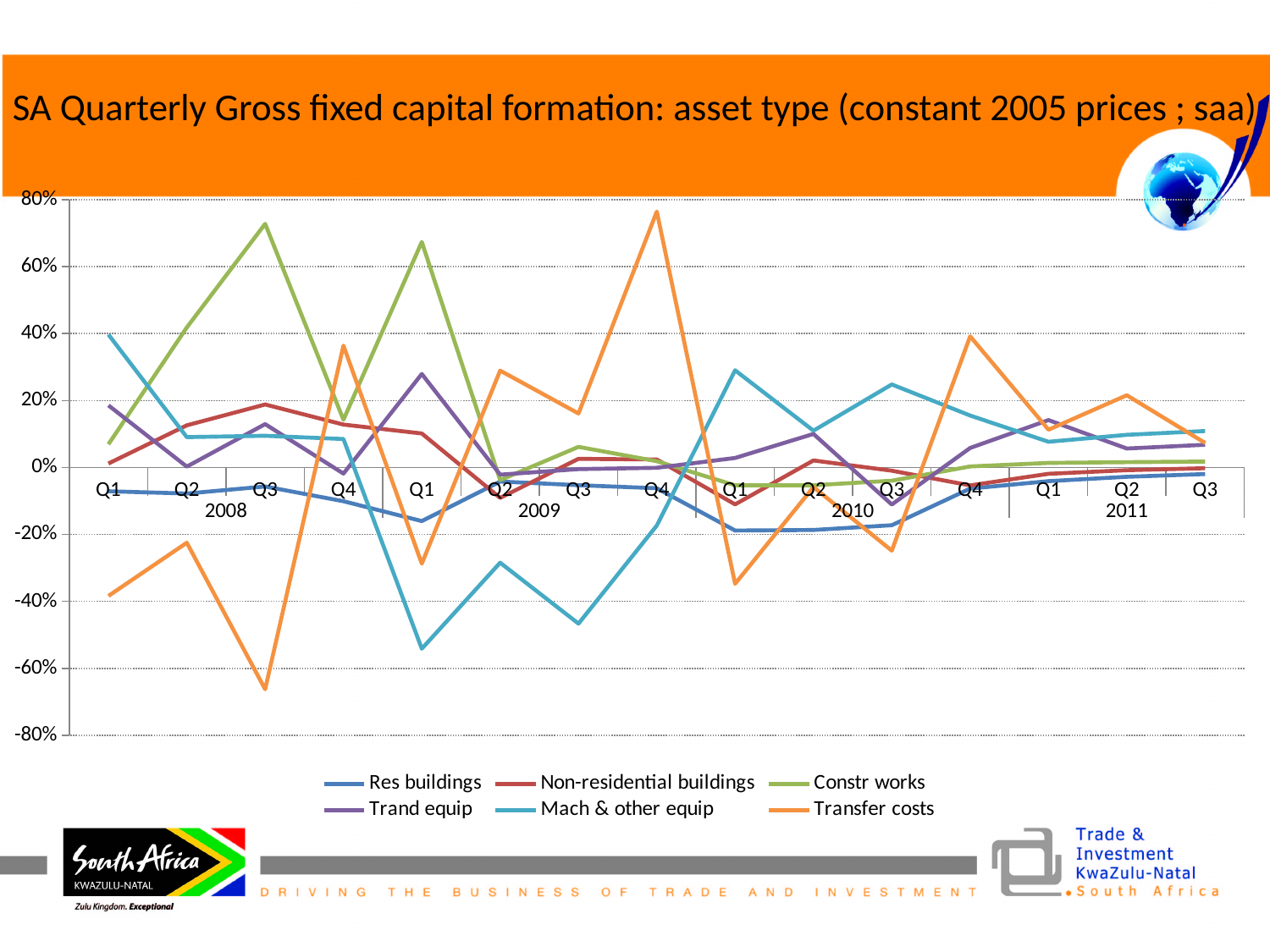
Is the value for Mach & other equip in Q1 2008 greater or less than 20%? greater Is the value for Constr works in Q3 2008 greater or less than 60%? greater Is the value for Transfer costs in Q4 2009 greater or less than 60%? greater How many series does the legend list? 6 Which series reaches the lowest value anywhere on the chart? Transfer costs In Q3 2008, which is higher: Constr works or Transfer costs? Constr works What is the title of the chart? SA Quarterly Gross fixed capital formation: asset type (constant 2005 prices ; saa) What kind of chart is shown on the slide? line chart How many quarterly points are plotted along the x axis? 15